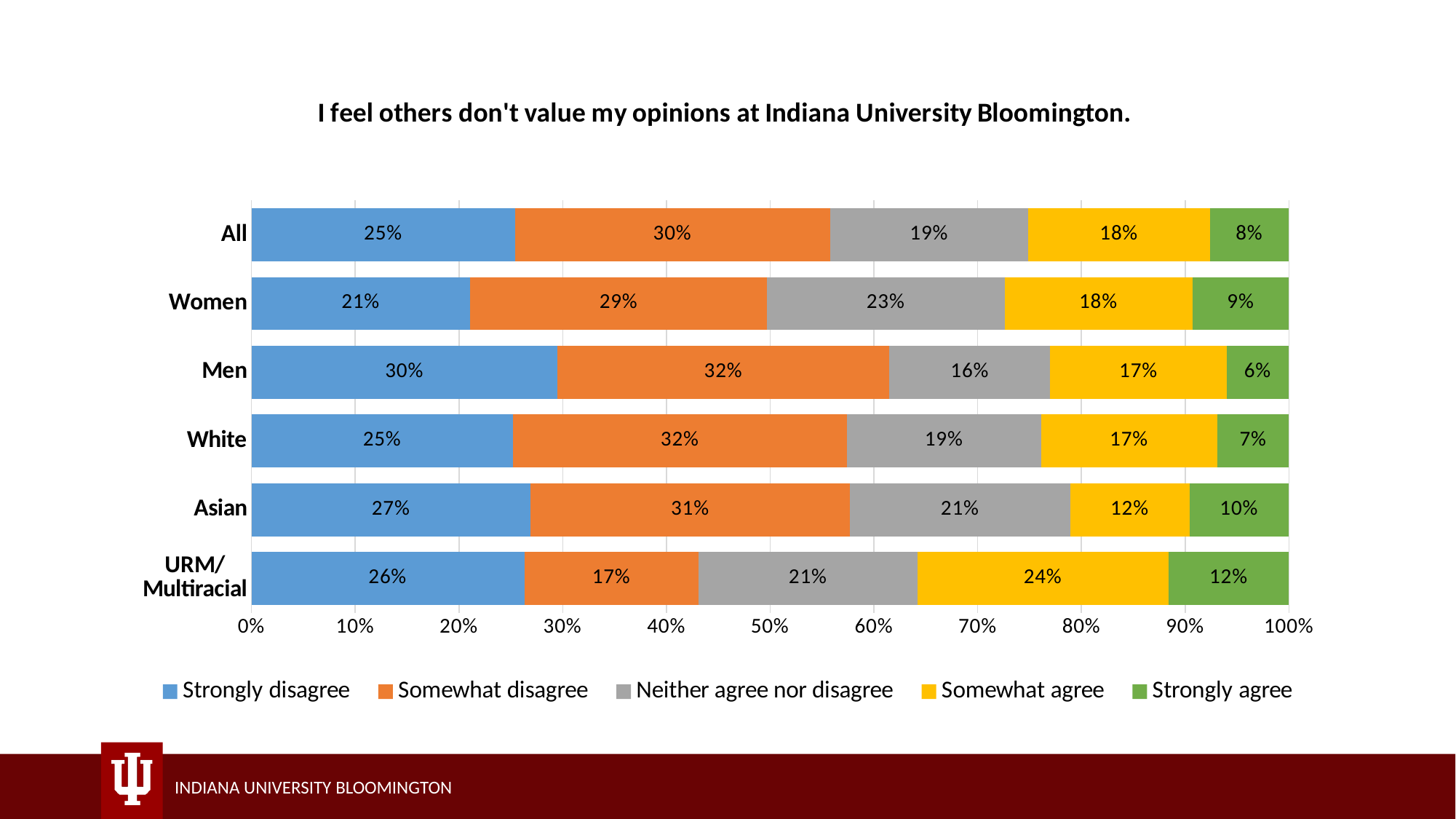
Which group has the lowest Somewhat disagree percentage? URM/Multiracial Which colour represents the Neither agree nor disagree series? Gray How many groups are shown on the y axis? 6 Which is larger: the Somewhat agree value for Asian or for Women? Women How many series does the legend list? 5 What is the combined percentage of Somewhat agree and Strongly agree for the All group? 26% What is the Somewhat agree value for the URM/Multiracial group? 24% What is the difference between the Strongly disagree percentages for Men and Women? 9% What kind of chart is shown on the slide? Stacked bar chart Which group has the highest Strongly agree percentage? URM/Multiracial What percentage of Asian respondents neither agree nor disagree? 21% What percentage of Men strongly disagree with the statement? 30%